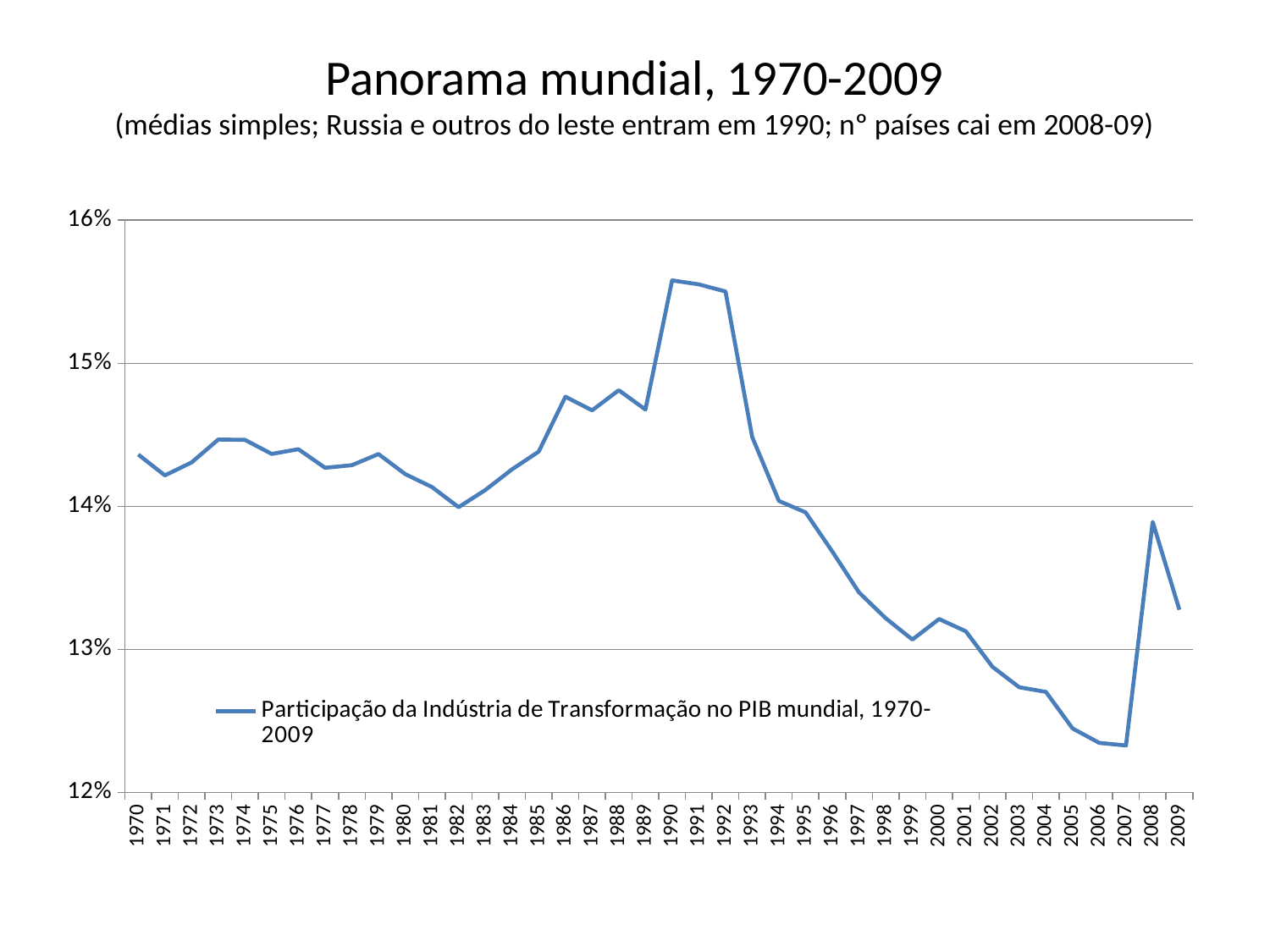
Which year has the larger value, 1990 or 2009? 1990 Is the value for 1986 greater or less than 14%? greater What is the title of the chart on the slide? Panorama mundial, 1970-2009 What kind of chart is shown on the slide? line chart Is the value for 2003 greater or less than 13%? less How many series does the legend list? 1 Is the value for 2007 greater or less than 13%? less In which year does the line reach its highest value? 1990 How many years are plotted along the x axis? 40 Does the line rise or fall between 2007 and 2008? rise Does the line rise or fall between 1992 and 1999? fall